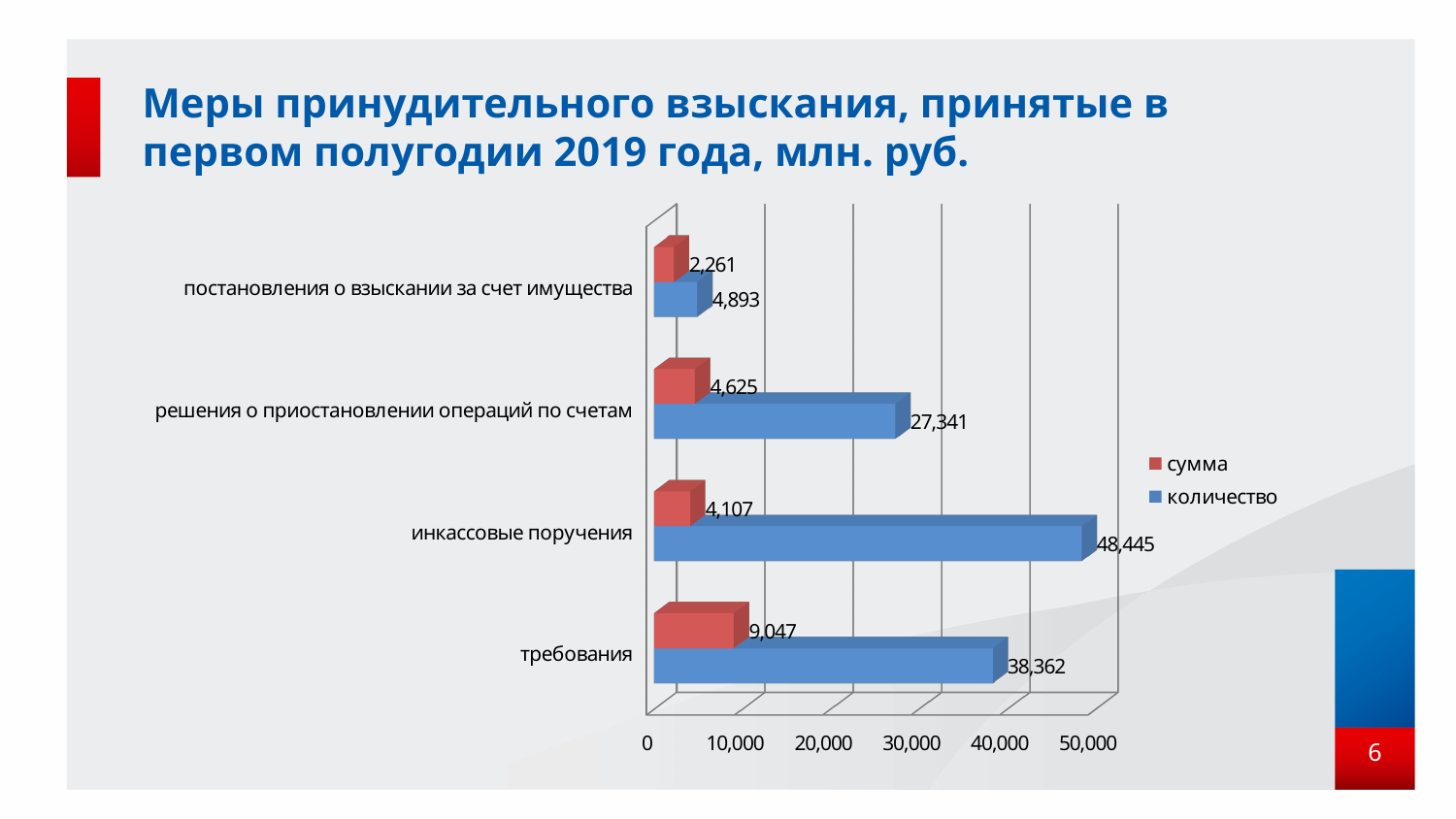
How many categories are shown on the chart? 4 What is the value of "количество" for "решения о приостановлении операций по счетам"? 27,341 What is the difference between the "количество" values for "инкассовые поручения" and "требования"? 10,083 Is the "количество" value for "требования" greater or less than 30,000? greater What is the value of "сумма" for "постановления о взыскании за счет имущества"? 2,261 Which category has the lowest "сумма" value? постановления о взыскании за счет имущества Which category has the highest "количество" value? инкассовые поручения What kind of chart is shown on the slide? bar chart Which is larger: the "сумма" value for "решения о приостановлении операций по счетам" or for "инкассовые поручения"? решения о приостановлении операций по счетам What is the value of "количество" for "инкассовые поручения"? 48,445 How many series does the legend list? 2 What is the value of "сумма" for "требования"? 9,047